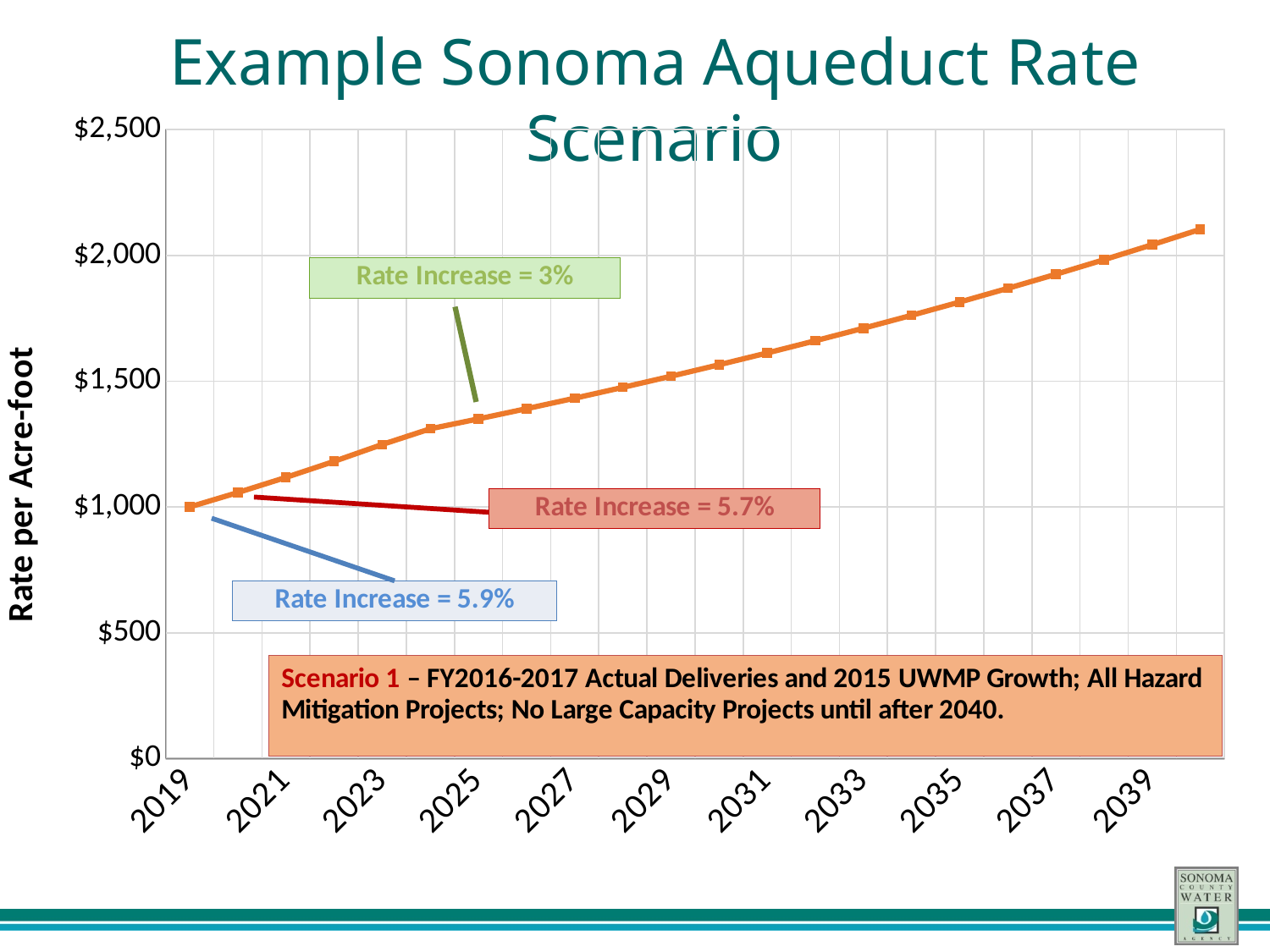
What rate increase is shown in the green annotation box? Rate Increase = 3% Do the rate values rise or fall from 2019 to 2040? rise What is the title of the chart? Example Sonoma Aqueduct Rate Scenario Is the rate for 2031 greater or less than $1,500? greater What kind of chart is shown on the slide? line chart Which year has the highest rate per acre-foot? 2040 Is the rate for 2023 greater or less than $1,000? greater Is the rate for 2025 greater or less than $1,500? less Which year has a higher rate, 2029 or 2035? 2035 Which year has the lowest rate per acre-foot? 2019 What is the label on the vertical axis? Rate per Acre-foot